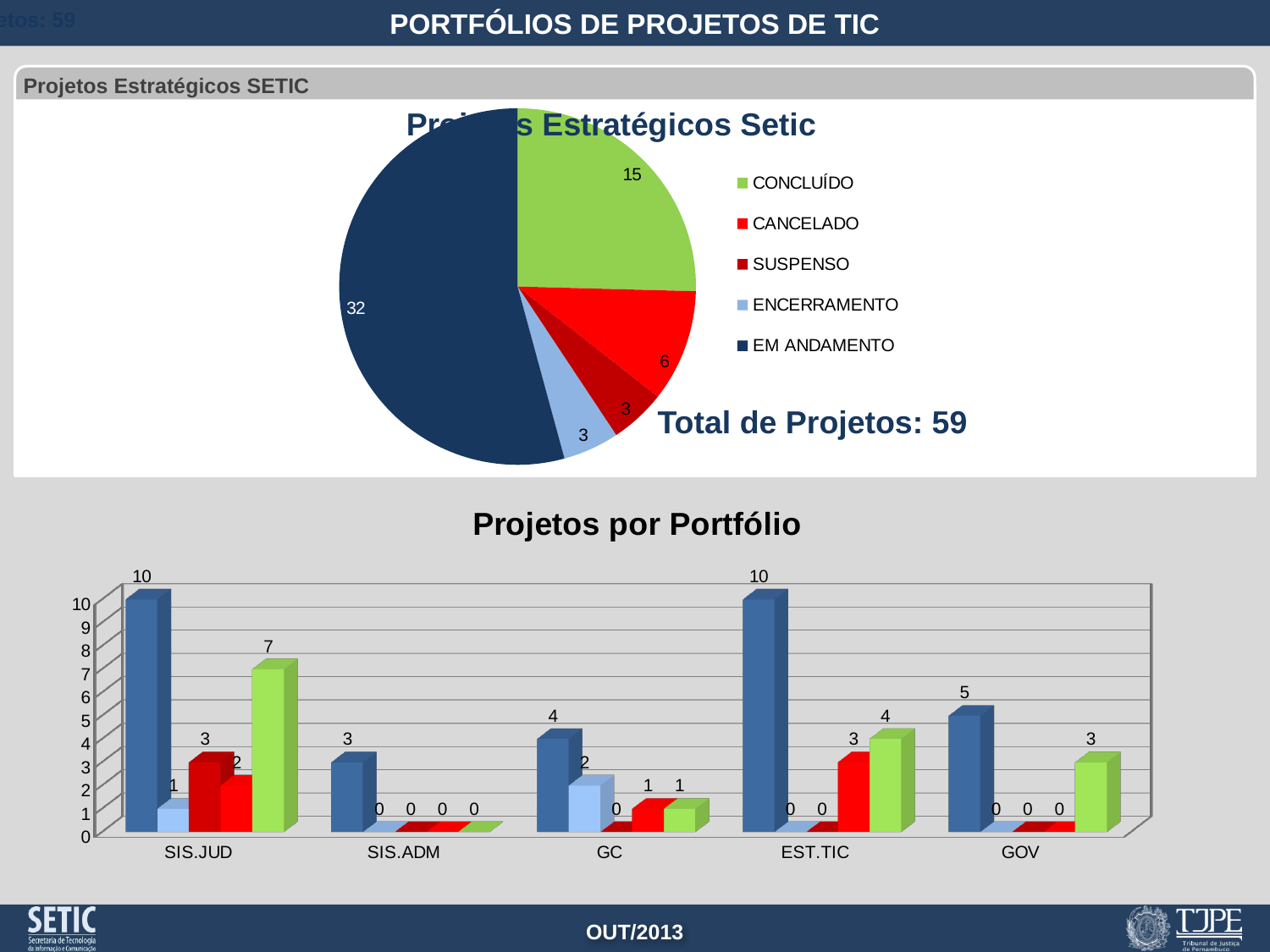
In the chart 'Projetos por Portfólio', which is larger: the green bar for EST.TIC or the green bar for GOV? EST.TIC In the chart 'Projetos por Portfólio', what is the value of the green (last) bar for SIS.JUD? 7 In the pie chart 'Projetos Estratégicos Setic', which category has the largest slice? EM ANDAMENTO In the chart 'Projetos por Portfólio', what is the difference between the dark blue bar for SIS.JUD and the dark blue bar for SIS.ADM? 7 In the pie chart 'Projetos Estratégicos Setic', what is the difference between CONCLUÍDO and CANCELADO? 9 In the pie chart 'Projetos Estratégicos Setic', what is the value for EM ANDAMENTO? 32 In the pie chart 'Projetos Estratégicos Setic', how many categories does the legend list? 5 In the chart 'Projetos por Portfólio', how many portfolio categories are shown on the x axis? 5 In the pie chart 'Projetos Estratégicos Setic', what is the value for CONCLUÍDO? 15 What kind of chart is 'Projetos por Portfólio'? bar chart In the pie chart 'Projetos Estratégicos Setic', what total number of projects is stated on the slide? 59 In the chart 'Projetos por Portfólio', what is the value of the dark blue (first) bar for GOV? 5